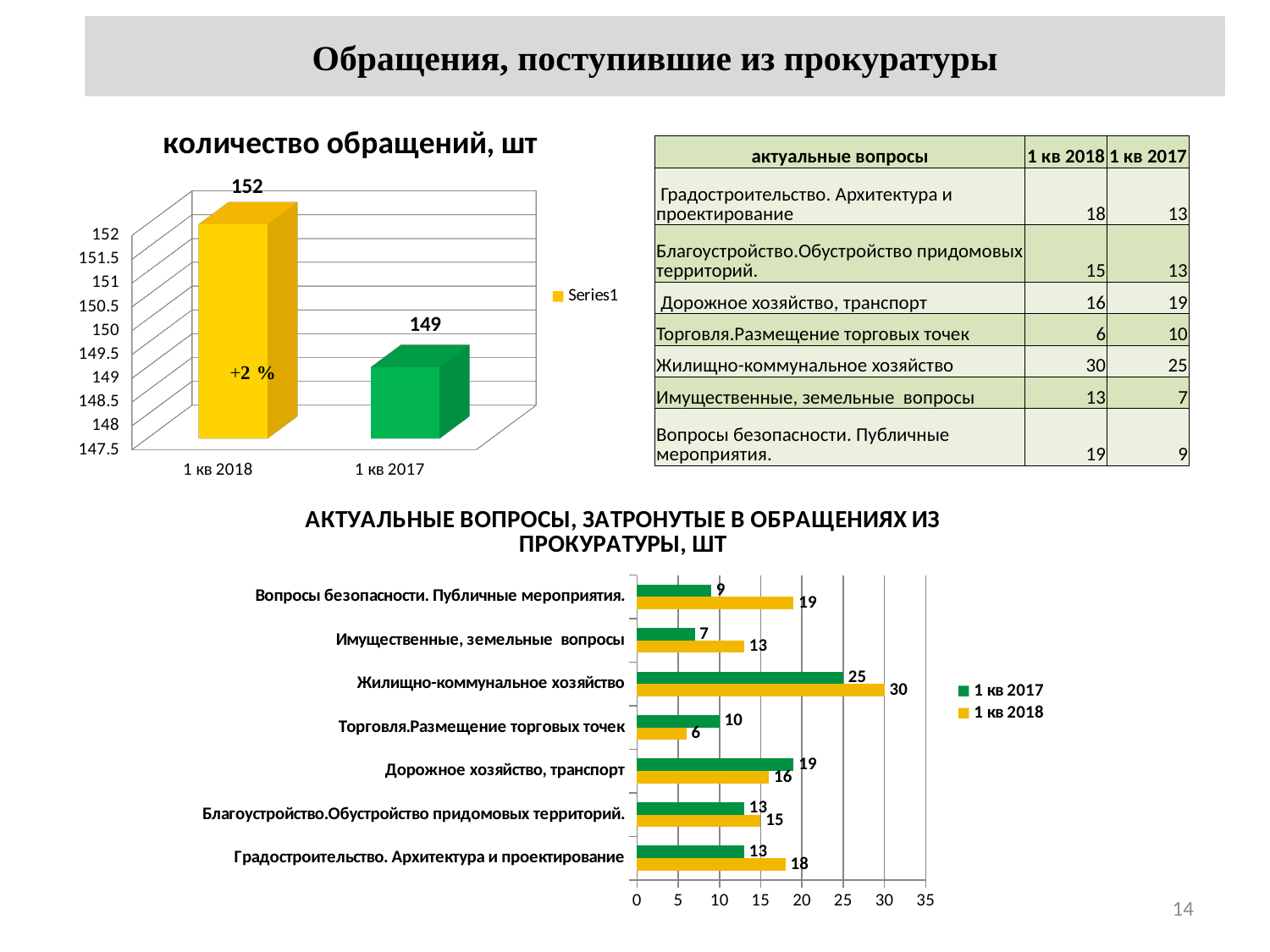
What kind of chart is the one titled 'АКТУАЛЬНЫЕ ВОПРОСЫ, ЗАТРОНУТЫЕ В ОБРАЩЕНИЯХ ИЗ ПРОКУРАТУРЫ, ШТ'? Bar chart In the chart titled 'АКТУАЛЬНЫЕ ВОПРОСЫ, ЗАТРОНУТЫЕ В ОБРАЩЕНИЯХ ИЗ ПРОКУРАТУРЫ, ШТ', which category has the lowest value for 1 кв 2017? Имущественные, земельные вопросы In the chart titled 'АКТУАЛЬНЫЕ ВОПРОСЫ, ЗАТРОНУТЫЕ В ОБРАЩЕНИЯХ ИЗ ПРОКУРАТУРЫ, ШТ', what is the difference between the 1 кв 2018 and 1 кв 2017 values for Вопросы безопасности. Публичные мероприятия.? 10 In the chart titled 'АКТУАЛЬНЫЕ ВОПРОСЫ, ЗАТРОНУТЫЕ В ОБРАЩЕНИЯХ ИЗ ПРОКУРАТУРЫ, ШТ', which category has the highest value for 1 кв 2018? Жилищно-коммунальное хозяйство In the chart titled 'АКТУАЛЬНЫЕ ВОПРОСЫ, ЗАТРОНУТЫЕ В ОБРАЩЕНИЯХ ИЗ ПРОКУРАТУРЫ, ШТ', how many series does the legend list? 2 In the chart titled 'количество обращений, шт', what is the value for 1 кв 2017? 149 In the chart titled 'АКТУАЛЬНЫЕ ВОПРОСЫ, ЗАТРОНУТЫЕ В ОБРАЩЕНИЯХ ИЗ ПРОКУРАТУРЫ, ШТ', which is larger for Дорожное хозяйство, транспорт: the 1 кв 2017 value or the 1 кв 2018 value? 1 кв 2017 In the chart titled 'АКТУАЛЬНЫЕ ВОПРОСЫ, ЗАТРОНУТЫЕ В ОБРАЩЕНИЯХ ИЗ ПРОКУРАТУРЫ, ШТ', what is the value for Торговля.Размещение торговых точек in 1 кв 2017? 10 In the chart titled 'АКТУАЛЬНЫЕ ВОПРОСЫ, ЗАТРОНУТЫЕ В ОБРАЩЕНИЯХ ИЗ ПРОКУРАТУРЫ, ШТ', what is the value for Жилищно-коммунальное хозяйство in 1 кв 2018? 30 In the chart titled 'количество обращений, шт', what is the difference between the values for 1 кв 2018 and 1 кв 2017? 3 In the chart titled 'количество обращений, шт', what is the value for 1 кв 2018? 152 In the chart titled 'количество обращений, шт', how many categories are shown on the x axis? 2